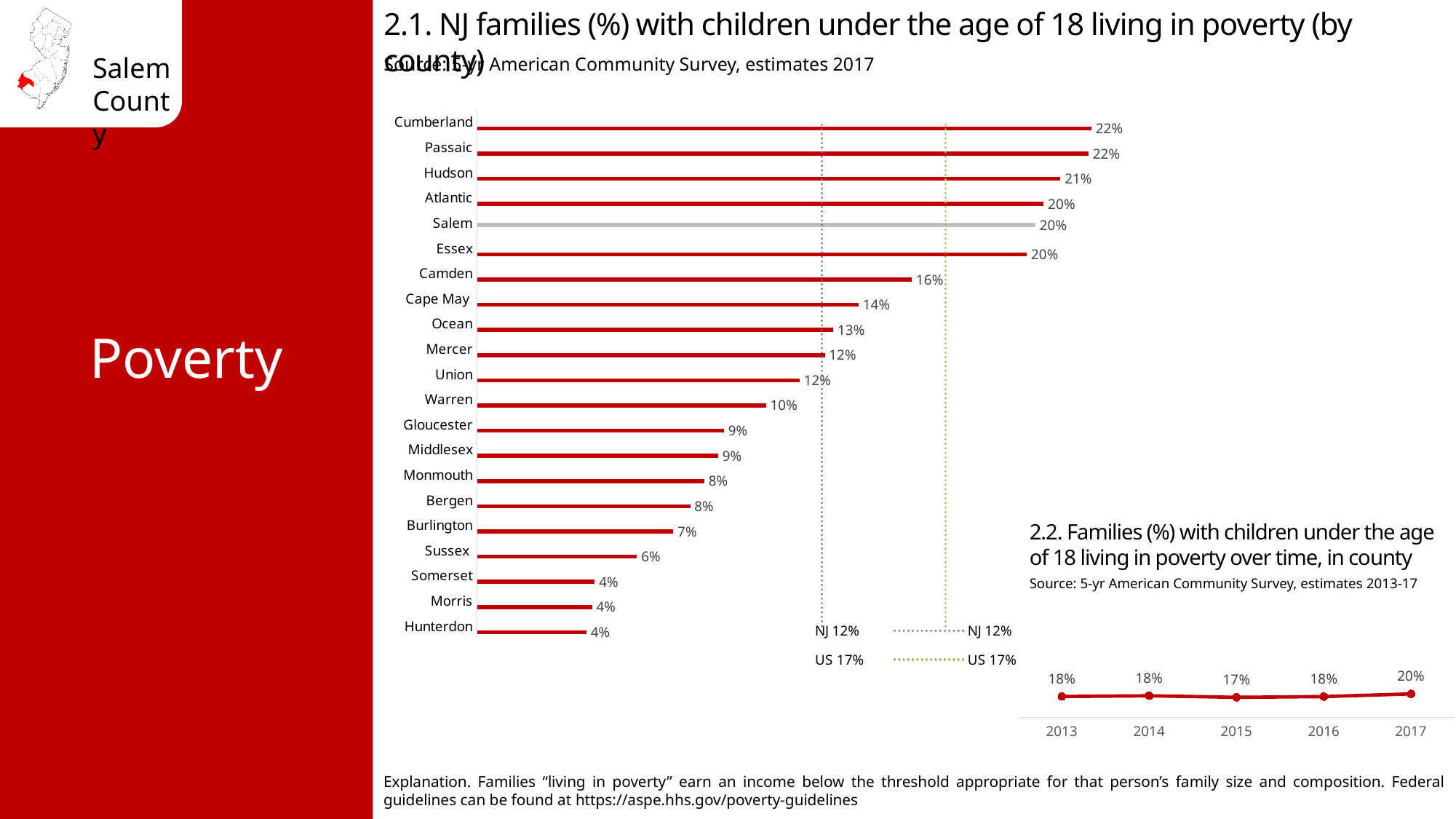
In chart 2.1 (by county), which county has the lowest value? Hunterdon, Morris and Somerset (tied at 4%) In chart 2.1 (by county), what is the US reference value shown by the dotted line? 17% In chart 2.1 (by county), what is the NJ reference value shown by the dotted line? 12% In chart 2.1 (NJ families with children under 18 living in poverty by county), what is the value for Salem? 20% In chart 2.2 (poverty over time, in county), how many years are plotted? 5 In chart 2.2 (poverty over time, in county), what is the value for 2017? 20% In chart 2.2 (poverty over time, in county), which year has the lowest value? 2015 What kind of chart is chart 2.1 (by county)? Bar chart In chart 2.1 (by county), what is the value for Camden? 16% In chart 2.1 (by county), which is larger, the value for Cape May or the value for Warren? Cape May In chart 2.1 (by county), what is the difference between Cumberland and Hunterdon? 18% In chart 2.1 (by county), how many counties are plotted? 21